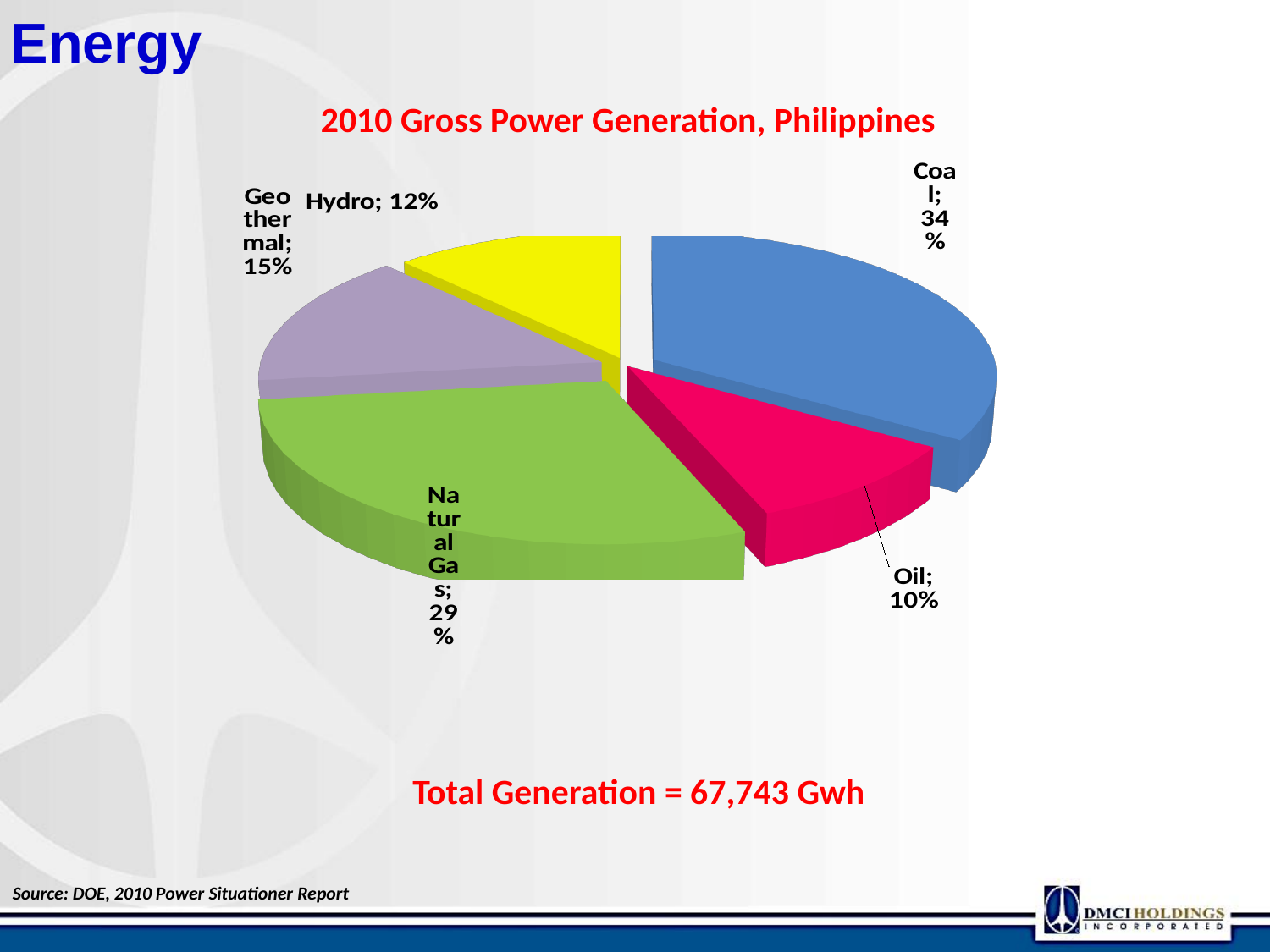
Which energy source has the smallest share of the pie? Oil What is the title of the chart? 2010 Gross Power Generation, Philippines How many slices does the pie chart have? 5 What is the difference in percentage points between the Coal share and the Natural Gas share? 5 percentage points Which has a larger share, Geothermal or Hydro? Geothermal What share of gross power generation does Coal account for? 34% What share of gross power generation does Oil account for? 10% What share of gross power generation does Geothermal account for? 15% What kind of chart is shown on the slide? Pie chart Which energy source has the largest share of the pie? Coal What share of gross power generation does Hydro account for? 12% What share of gross power generation does Natural Gas account for? 29%